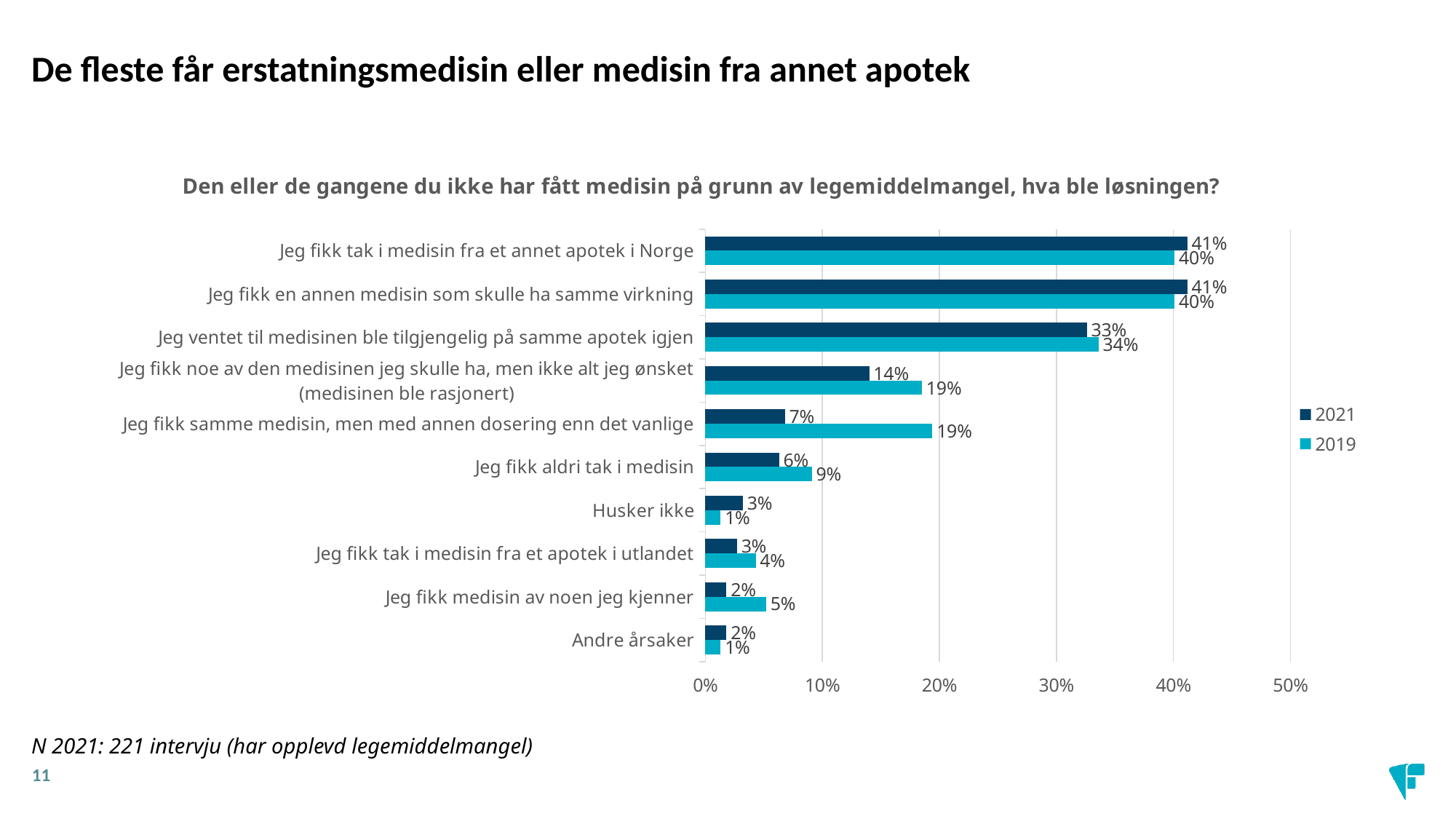
What is the 2021 value for "Jeg ventet til medisinen ble tilgjengelig på samme apotek igjen"? 33% For "Jeg fikk aldri tak i medisin", which year has the larger value, 2021 or 2019? 2019 What is the 2021 value for "Jeg fikk medisin av noen jeg kjenner"? 2% What kind of chart is shown on the slide? Bar chart Which category has the lowest 2019 value, "Husker ikke" or "Jeg fikk tak i medisin fra et apotek i utlandet"? Husker ikke How many categories are shown on the chart? 10 What is the difference between the 2019 and 2021 values for "Jeg fikk samme medisin, men med annen dosering enn det vanlige"? 12 percentage points What is the 2019 value for "Jeg fikk aldri tak i medisin"? 9% How many series does the legend list? 2 Is the 2021 value for "Jeg fikk tak i medisin fra et annet apotek i Norge" greater or less than 30%? greater What is the 2019 value for "Jeg fikk samme medisin, men med annen dosering enn det vanlige"? 19% What is the difference between the 2019 and 2021 values for "Jeg fikk noe av den medisinen jeg skulle ha, men ikke alt jeg ønsket (medisinen ble rasjonert)"? 5 percentage points